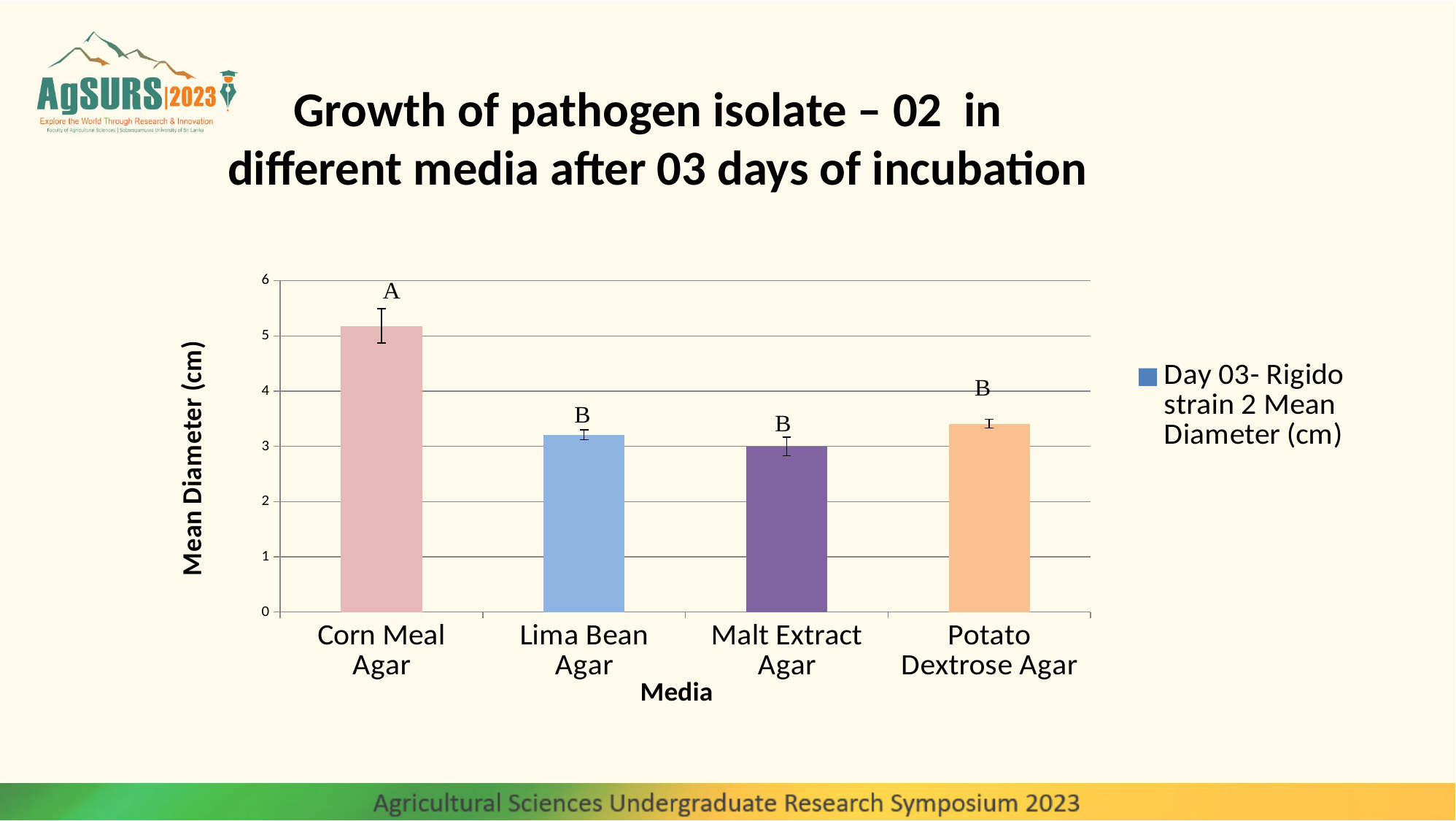
Which medium has the lowest mean diameter? Malt Extract Agar What letter is printed above the Corn Meal Agar bar? A Which has a larger mean diameter, Corn Meal Agar or Potato Dextrose Agar? Corn Meal Agar Which medium has the highest mean diameter? Corn Meal Agar How many series does the legend list? 1 How many media categories are plotted on the x axis? 4 Is the value for Corn Meal Agar greater or less than 5? greater What kind of chart is shown on the slide? bar chart Is the value for Potato Dextrose Agar greater or less than 4? less Which has a larger mean diameter, Potato Dextrose Agar or Lima Bean Agar? Potato Dextrose Agar What is the title of the y axis? Mean Diameter (cm)